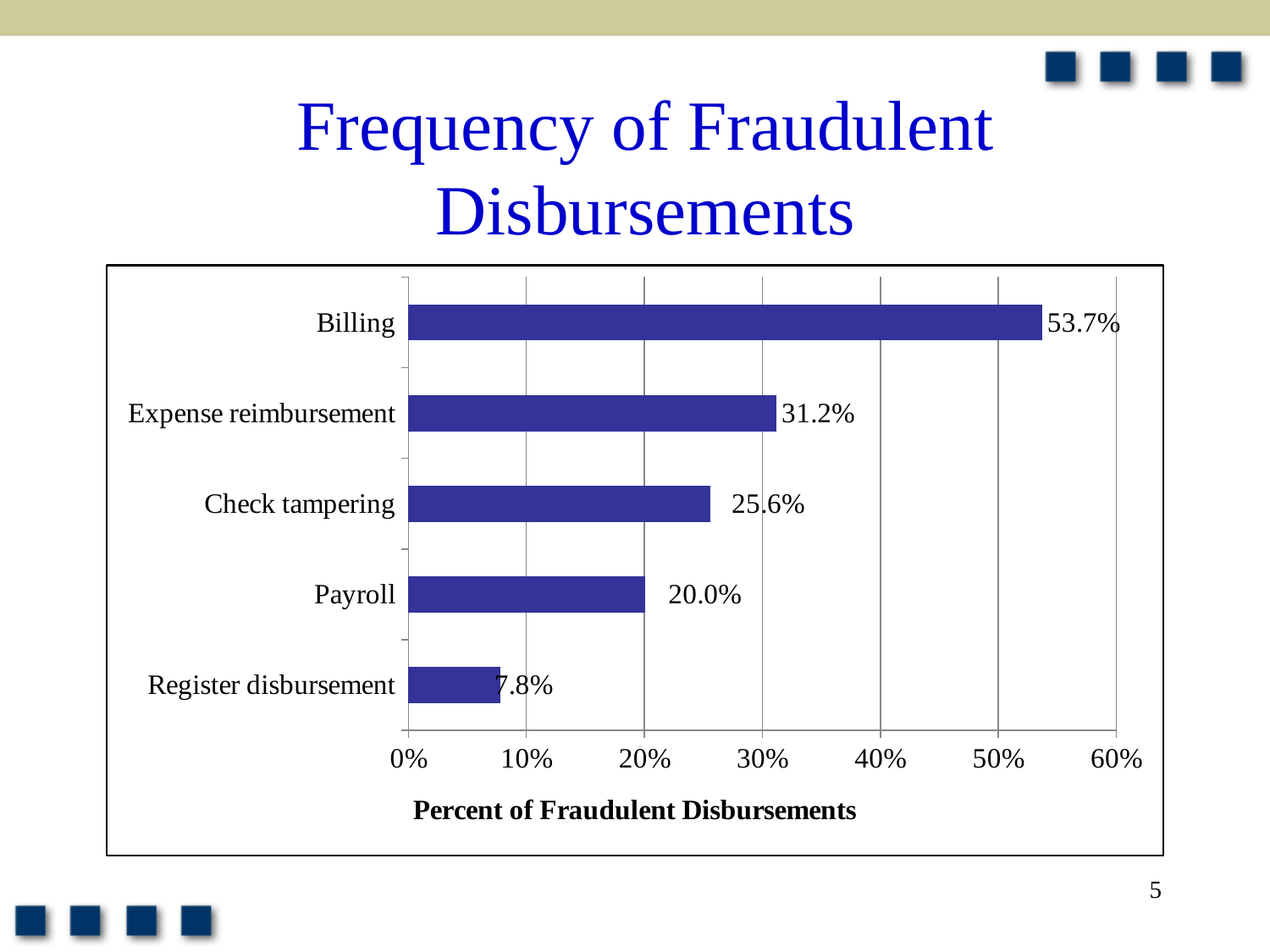
How many categories are shown in the chart? 5 What is the value for Expense reimbursement? 31.2% What is the value for Check tampering? 25.6% Which is larger, the value for Check tampering or the value for Payroll? Check tampering What is the label of the horizontal axis? Percent of Fraudulent Disbursements What is the value for Billing? 53.7% Which category has the lowest value? Register disbursement What kind of chart is shown on the slide? Bar chart What is the difference between the values for Billing and Expense reimbursement? 22.5% What is the value for Payroll? 20.0% Which category has the highest value? Billing What is the value for Register disbursement? 7.8%